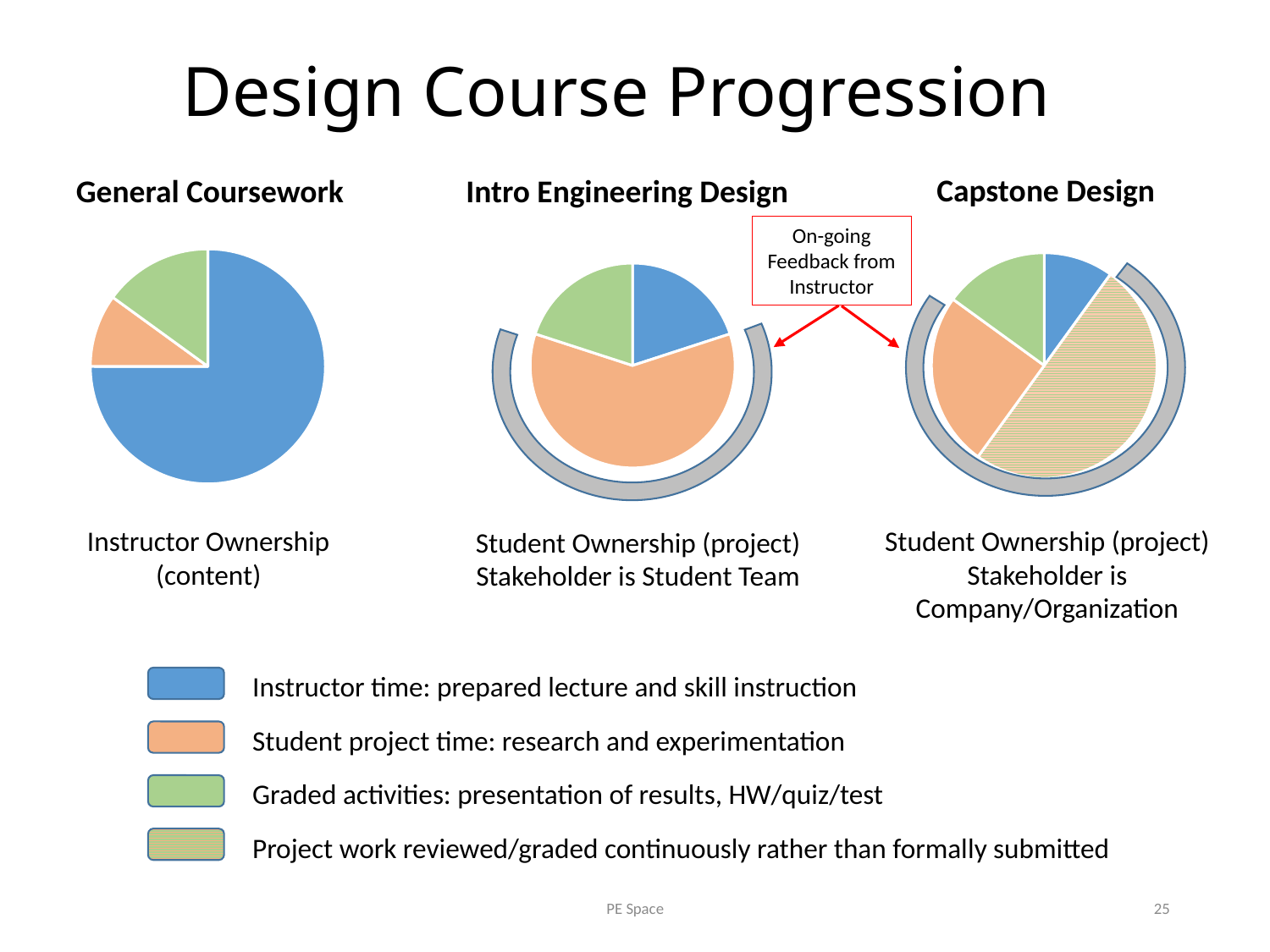
What kind of chart is used for General Coursework? pie chart In the General Coursework pie chart, which category takes the largest share? Instructor time: prepared lecture and skill instruction In the Capstone Design pie chart, which category takes the smallest share? Instructor time: prepared lecture and skill instruction How many slices does the Capstone Design pie chart have? 4 In the Intro Engineering Design pie chart, is the share for student project time larger or smaller than the share for instructor time? larger In the Intro Engineering Design pie chart, which category takes the largest share? Student project time: research and experimentation In the General Coursework pie chart, is the share for instructor time larger or smaller than the share for student project time? larger How many slices does the General Coursework pie chart have? 3 In the Capstone Design pie chart, which category takes the largest share? Project work reviewed/graded continuously rather than formally submitted Which colour represents 'Graded activities: presentation of results, HW/quiz/test' in the pie charts? green What is the title of the slide containing the three pie charts? Design Course Progression How many entries does the legend at the bottom of the slide list? 4